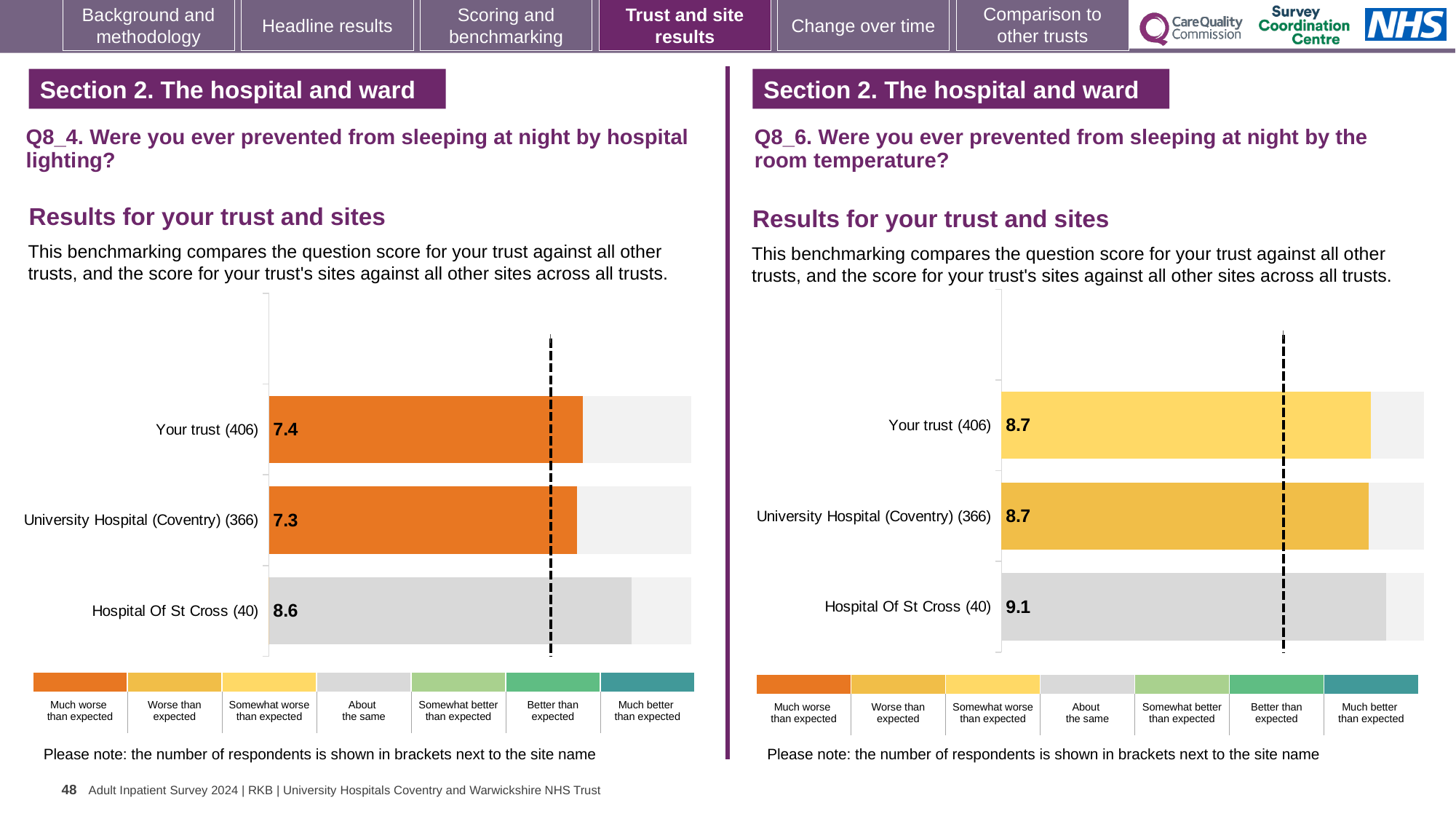
In the Q8_6 room temperature chart, which site has the highest score? Hospital Of St Cross (40) In the Q8_6 room temperature chart, what is the score for Hospital Of St Cross (40)? 9.1 How many sites or rows are plotted in the Q8_4 hospital lighting chart? 3 In the Q8_4 hospital lighting chart, what is the difference between the scores for Hospital Of St Cross (40) and University Hospital (Coventry) (366)? 1.3 In the Q8_6 room temperature chart, what is the difference between the scores for Hospital Of St Cross (40) and Your trust (406)? 0.4 What kind of chart is used in the Q8_6 room temperature chart? Bar chart In the Q8_6 room temperature chart, what is the score for Your trust (406)? 8.7 In the Q8_4 hospital lighting chart, what is the score for Your trust (406)? 7.4 In the Q8_4 hospital lighting chart, what is the score for Hospital Of St Cross (40)? 8.6 In the Q8_4 hospital lighting chart, what is the score for University Hospital (Coventry) (366)? 7.3 In the Q8_4 hospital lighting chart, which benchmark category does the colour of the Your trust (406) bar correspond to? Much worse than expected In the Q8_4 hospital lighting chart, which site has the highest score? Hospital Of St Cross (40)